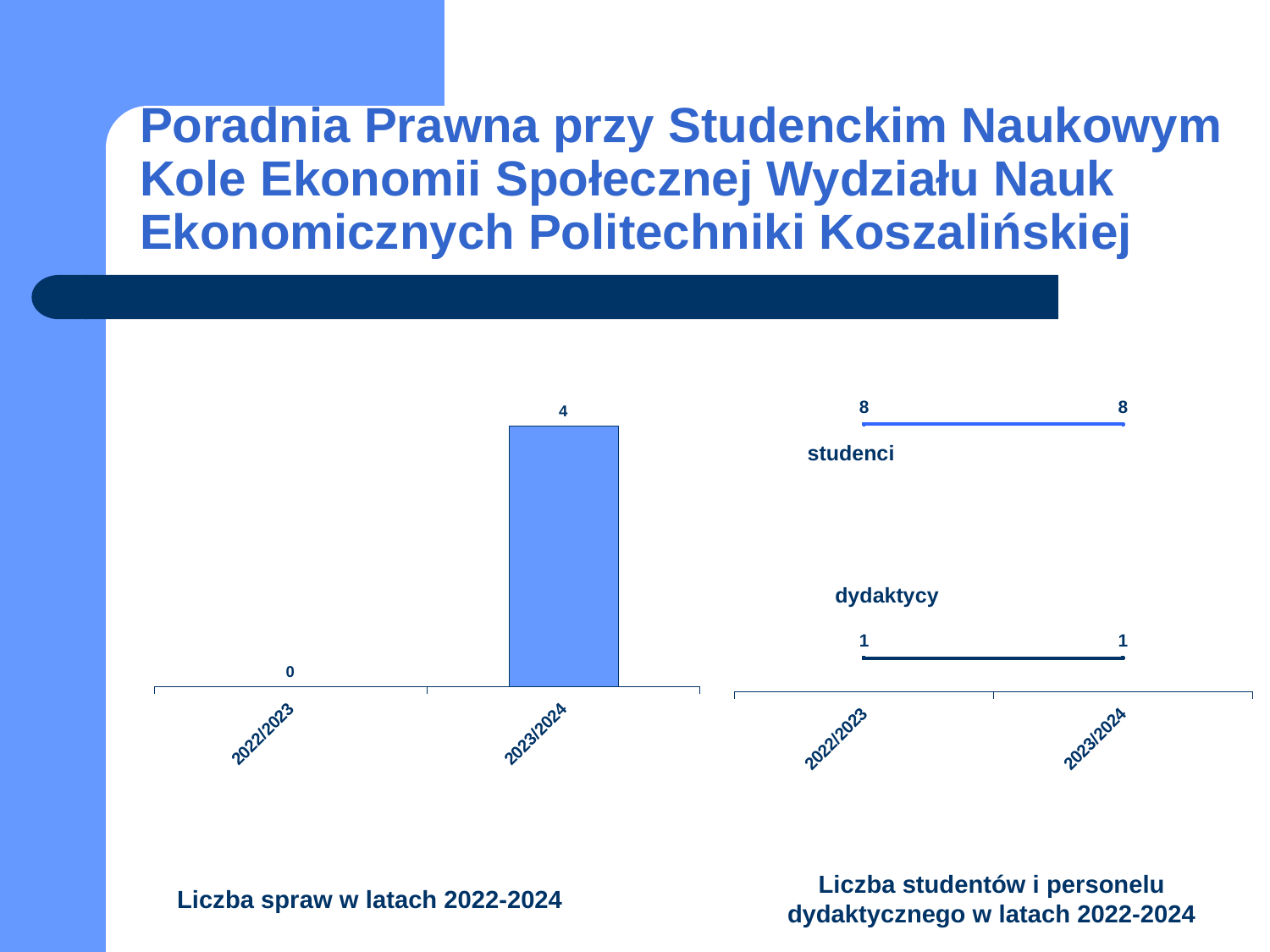
In the chart titled "Liczba spraw w latach 2022-2024", do the values rise or fall from 2022/2023 to 2023/2024? rise In the chart titled "Liczba spraw w latach 2022-2024", how many categories are shown on the x axis? 2 In the chart titled "Liczba studentów i personelu dydaktycznego w latach 2022-2024", which series has the larger value in 2022/2023, studenci or dydaktycy? studenci In the chart titled "Liczba spraw w latach 2022-2024", what is the difference between the values for 2023/2024 and 2022/2023? 4 In the chart titled "Liczba studentów i personelu dydaktycznego w latach 2022-2024", what is the value for studenci in 2023/2024? 8 In the chart titled "Liczba studentów i personelu dydaktycznego w latach 2022-2024", what is the value for dydaktycy in 2022/2023? 1 In the chart titled "Liczba spraw w latach 2022-2024", what is the value for 2023/2024? 4 In the chart titled "Liczba spraw w latach 2022-2024", which category has the highest value? 2023/2024 What kind of chart is the one titled "Liczba studentów i personelu dydaktycznego w latach 2022-2024"? line chart In the chart titled "Liczba spraw w latach 2022-2024", what is the value for 2022/2023? 0 In the chart titled "Liczba studentów i personelu dydaktycznego w latach 2022-2024", what is the difference between studenci and dydaktycy in 2023/2024? 7 What kind of chart is the one titled "Liczba spraw w latach 2022-2024"? bar chart